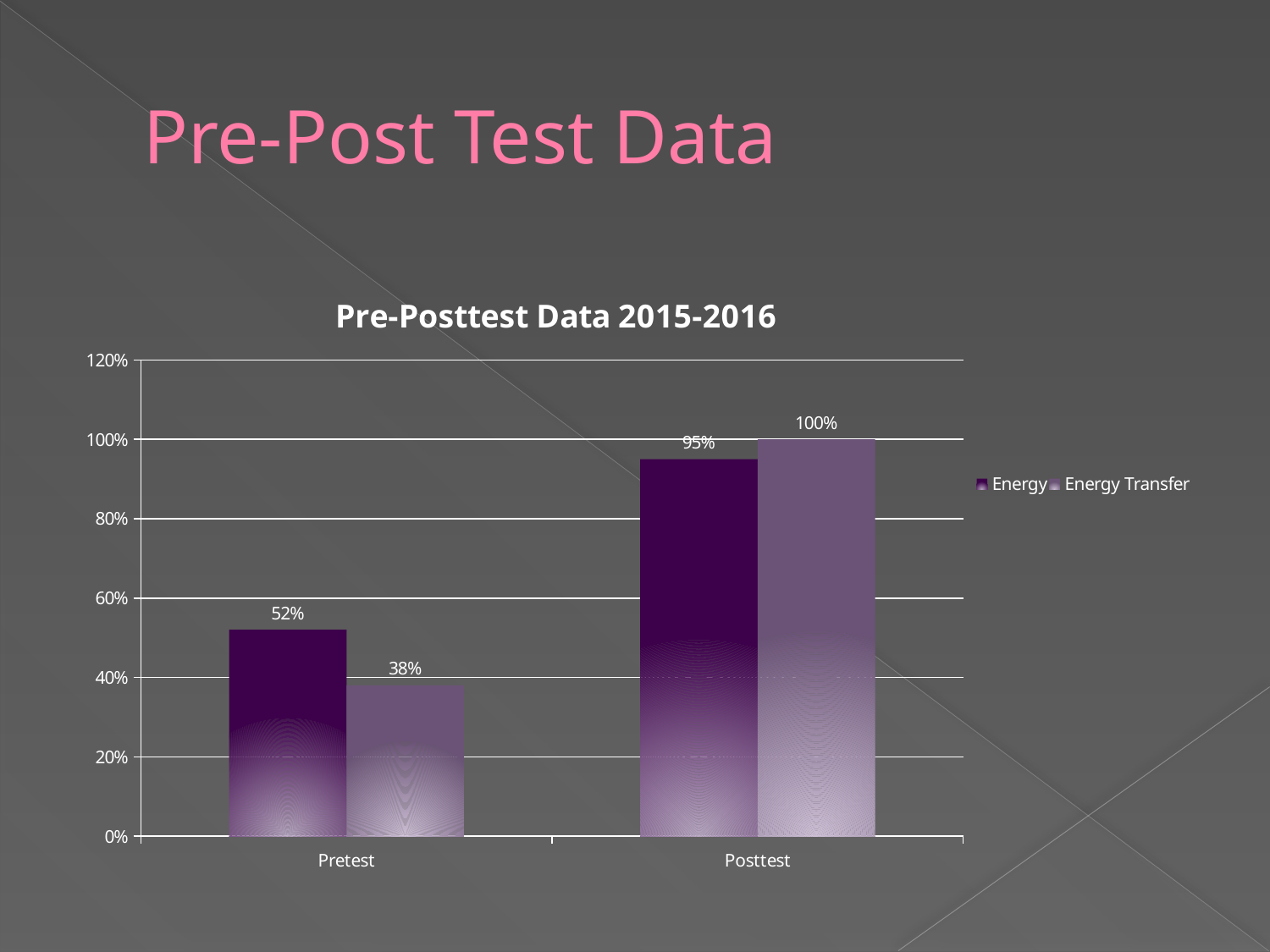
Which series has the lowest value in the Pretest category? Energy Transfer How many categories are shown on the x axis? 2 How many series does the legend list? 2 What is the difference between the Energy values for Posttest and Pretest? 43% What type of chart is shown? Bar chart What is the Energy value for Posttest? 95% What is the Energy Transfer value for Pretest? 38% What is the Energy Transfer value for Posttest? 100% Which is larger for Pretest, Energy or Energy Transfer? Energy What is the Energy value for Pretest? 52% Which series has the highest value in the Posttest category? Energy Transfer What is the difference between the Energy Transfer values for Posttest and Pretest? 62%